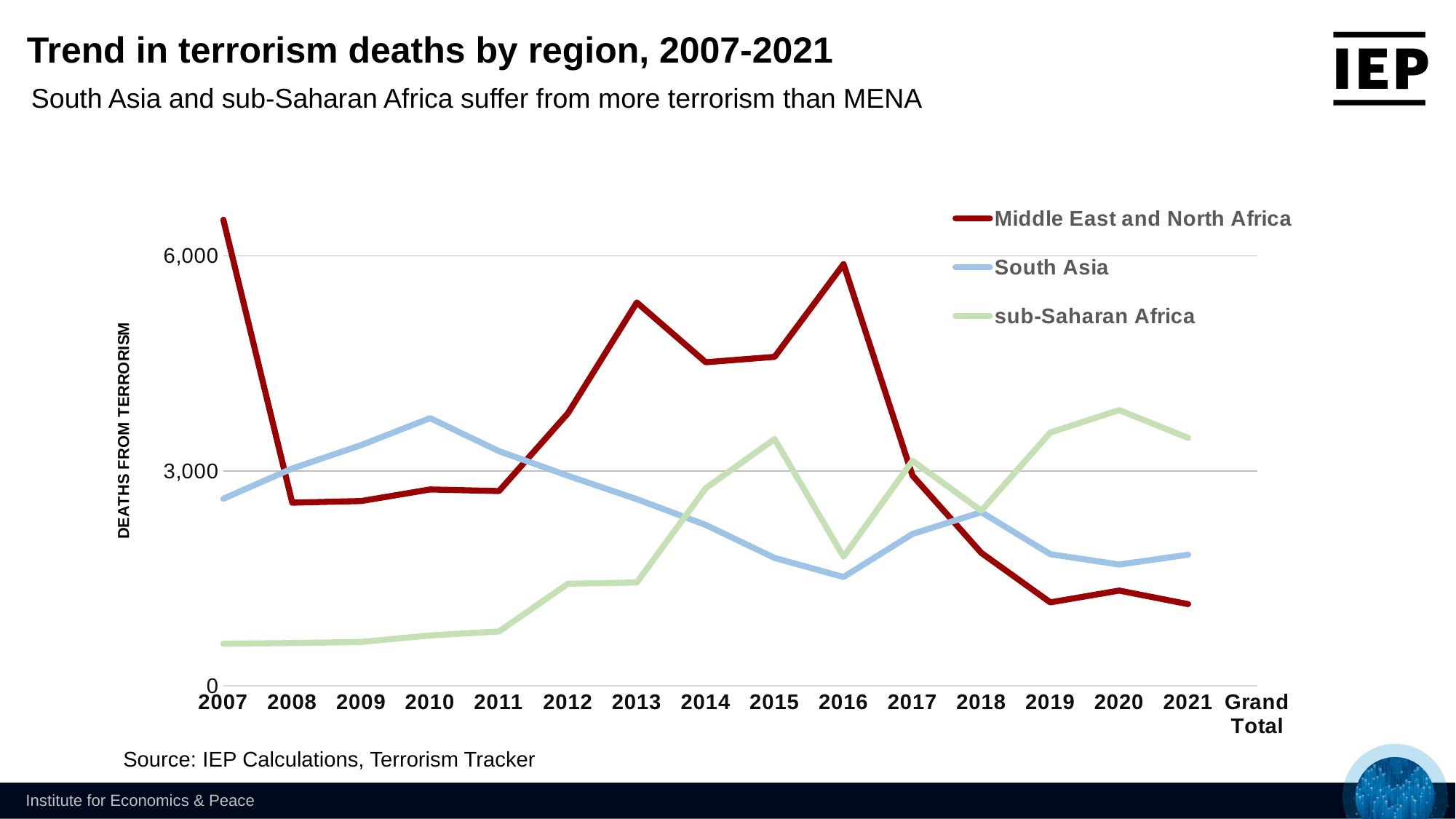
In 2013, which is larger: the value for Middle East and North Africa or the value for South Asia? Middle East and North Africa Does the Middle East and North Africa line rise or fall from 2016 to 2021? Fall In which year does the Middle East and North Africa line reach its highest value? 2007 How many years are plotted along the x axis, from 2007 to 2021? 15 Which region has the highest value in 2021? sub-Saharan Africa Is the value for South Asia in 2010 greater or less than 3,000? greater In which year does the South Asia line reach its lowest value? 2016 Is the value for Middle East and North Africa in 2007 greater or less than 6,000? greater How many series does the legend list? 3 Is the value for sub-Saharan Africa in 2007 greater or less than 3,000? less What kind of chart is shown on the slide? Line chart